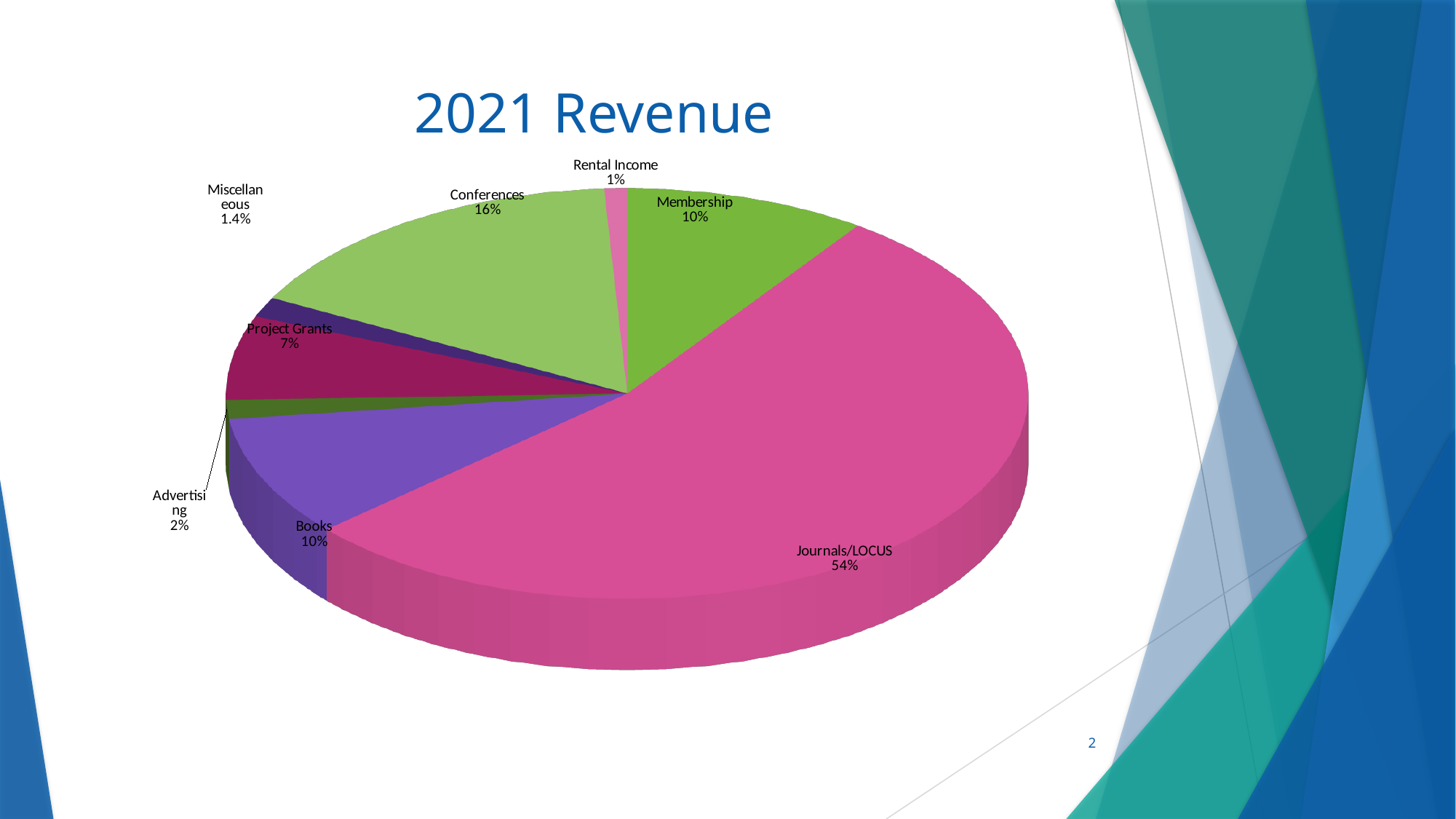
Which revenue source has the smallest share of 2021 Revenue? Rental Income Which revenue source has the largest share of 2021 Revenue? Journals/LOCUS How many percentage points larger is the Conferences share than the Membership share? 6 What percentage of 2021 Revenue is from Conferences? 16% What is the title of the chart on the slide? 2021 Revenue Which is larger in 2021 Revenue, Project Grants or Books? Books What percentage of 2021 Revenue is Miscellaneous? 1.4% What share of 2021 Revenue comes from Journals/LOCUS? 54% How many slices does the 2021 Revenue pie chart have? 8 What kind of chart is shown on the slide? Pie chart What share of 2021 Revenue comes from Advertising? 2% What share of 2021 Revenue does Project Grants account for? 7%